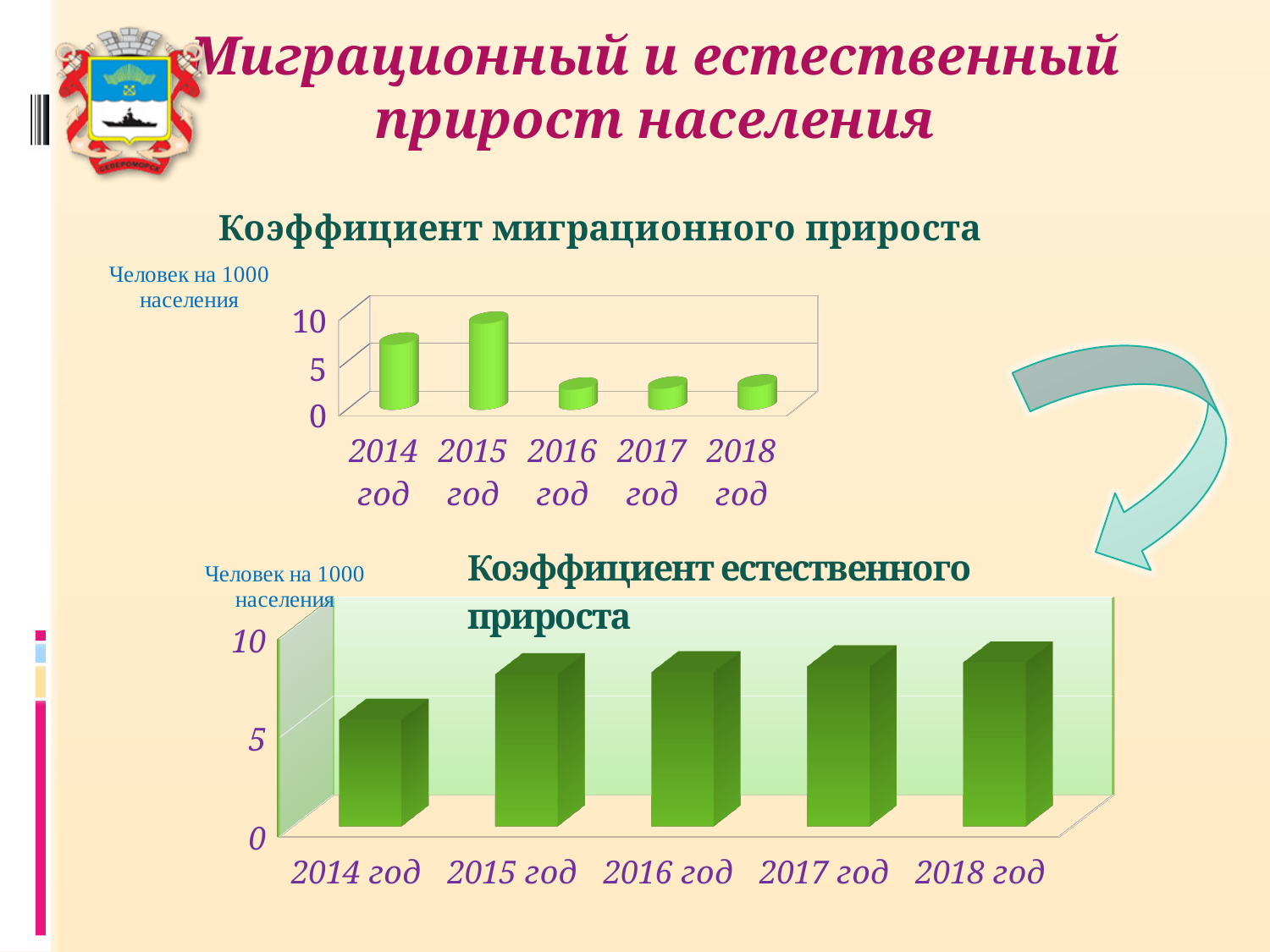
What unit is given on the vertical axis label of the 'Коэффициент миграционного прироста' chart? Человек на 1000 населения On the 'Коэффициент естественного прироста' chart, is the value for 2018 год greater or less than 5? greater On the 'Коэффициент естественного прироста' chart, do the values generally rise or fall from 2014 to 2018? rise On the 'Коэффициент миграционного прироста' chart, which year has the highest value? 2015 год On the 'Коэффициент естественного прироста' chart, which is larger: the value for 2014 год or 2017 год? 2017 год What kind of chart is the 'Коэффициент миграционного прироста' chart? bar chart On the 'Коэффициент миграционного прироста' chart, is the value for 2015 год greater or less than 5? greater On the 'Коэффициент миграционного прироста' chart, which is larger: the value for 2014 год or 2016 год? 2014 год On the 'Коэффициент миграционного прироста' chart, is the value for 2016 год greater or less than 5? less On the 'Коэффициент естественного прироста' chart, which year has the lowest value? 2014 год How many years are shown on the 'Коэффициент естественного прироста' chart? 5 How many charts are shown on the slide? 2